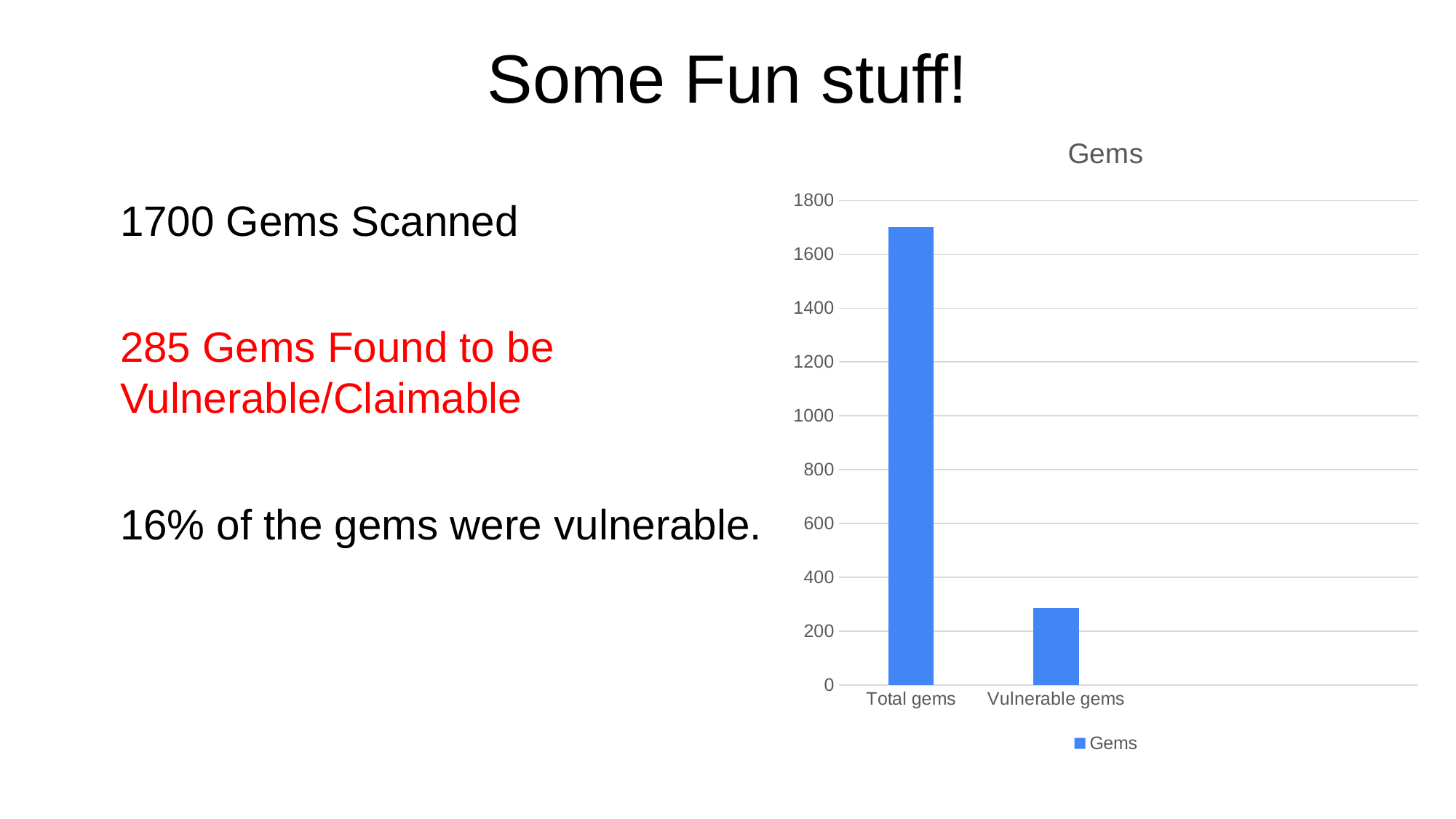
Which category has the highest bar in the chart? Total gems What kind of chart is shown on the slide? bar chart Is the value for Vulnerable gems greater or less than 400? less How many series does the chart legend list? 1 Is the value for Vulnerable gems greater or less than 200? greater What is the highest value shown on the y axis of the chart? 1800 Which is larger, the bar for Total gems or the bar for Vulnerable gems? Total gems Which category has the lowest bar in the chart? Vulnerable gems What is the title of the chart? Gems Is the value for Total gems greater or less than 1600? greater What is the name of the series shown in the chart legend? Gems How many categories are shown on the x axis of the chart? 2